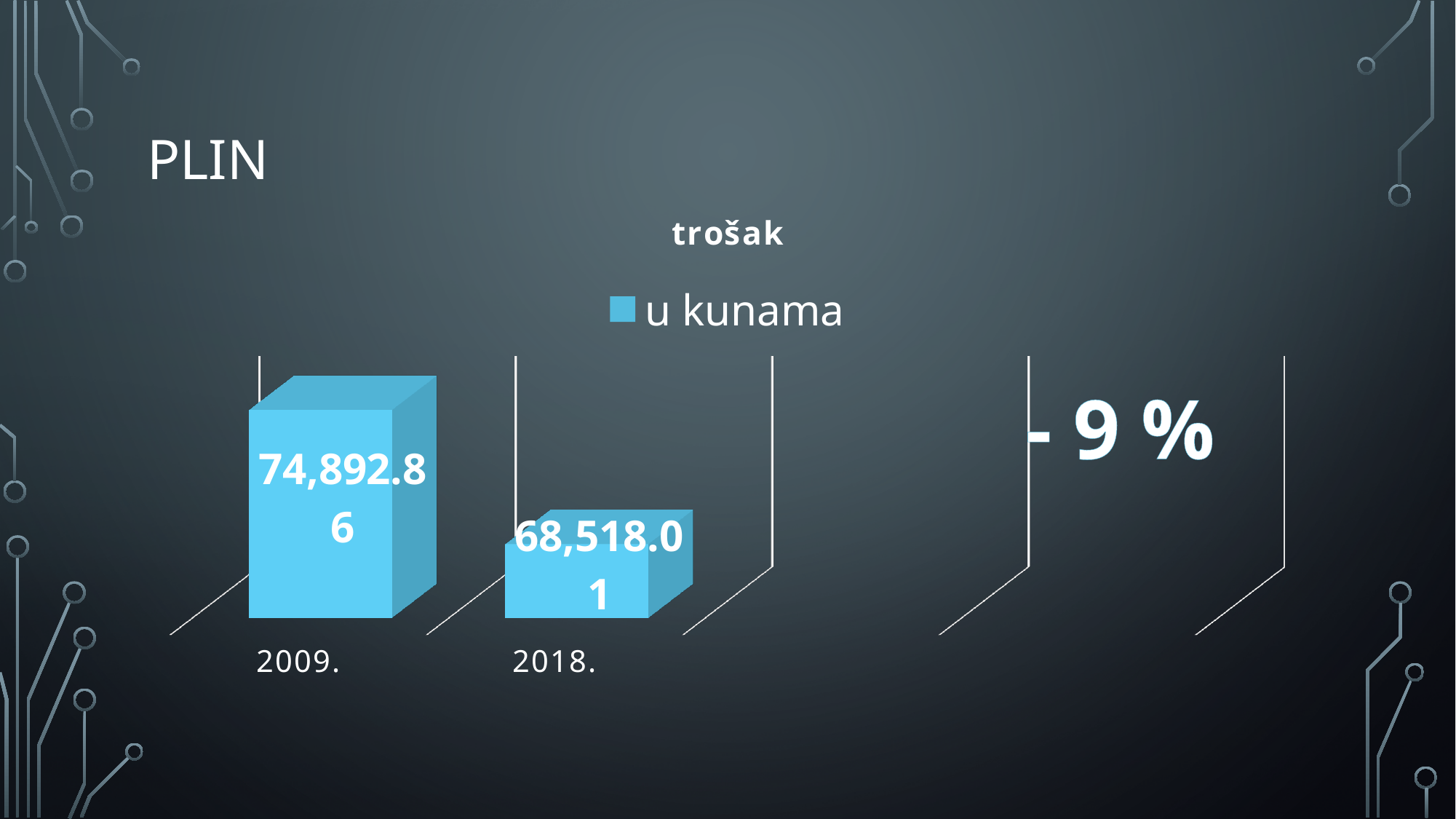
How many categories are shown on the x axis of the chart? 2 Do the values rise or fall from 2009. to 2018.? fall What is the name of the series in the chart legend? u kunama What is the title of the chart? trošak What is the value for 2018. in the chart? 68,518.01 What kind of chart is shown on the slide? bar chart Is the value for 2018. larger or smaller than the value for 2009.? smaller How many series does the chart legend list? 1 Which year has the higher value in the chart? 2009. Which year has the lower value in the chart? 2018. What is the difference between the 2009. value and the 2018. value? 6,374.85 What is the value for 2009. in the chart? 74,892.86